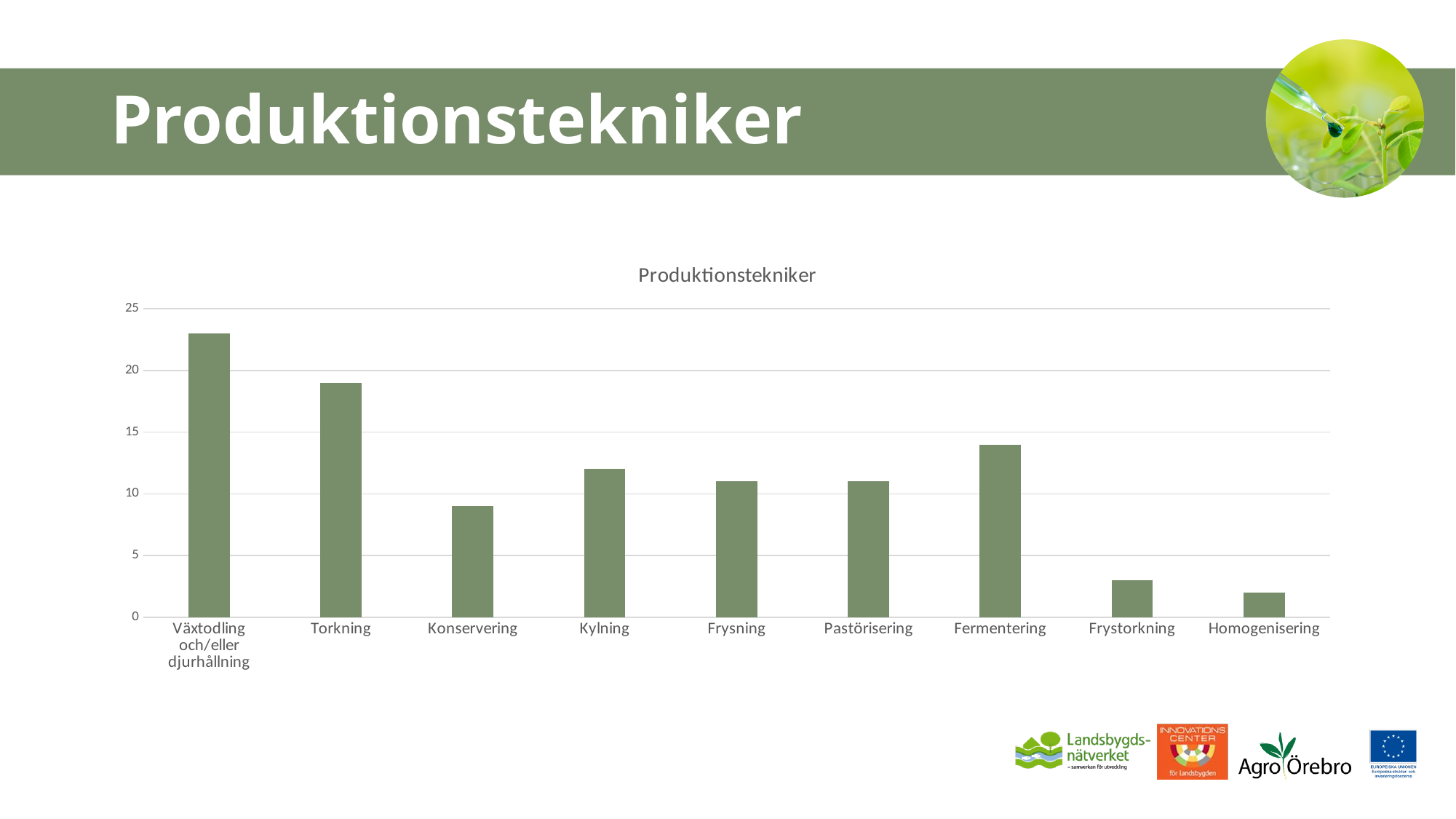
How many categories are shown on the x axis of the chart? 9 Is the value for Konservering greater or less than 10? less Which category has the highest bar in the chart? Växtodling och/eller djurhållning Is the value for Fermentering greater or less than 10? greater Is the value for Frystorkning greater or less than 5? less Which is larger, the value for Fermentering or the value for Frysning? Fermentering Which category has the lowest bar in the chart? Homogenisering What kind of chart is shown on the slide? bar chart Which is larger, the value for Kylning or the value for Konservering? Kylning What is the title of the chart? Produktionstekniker